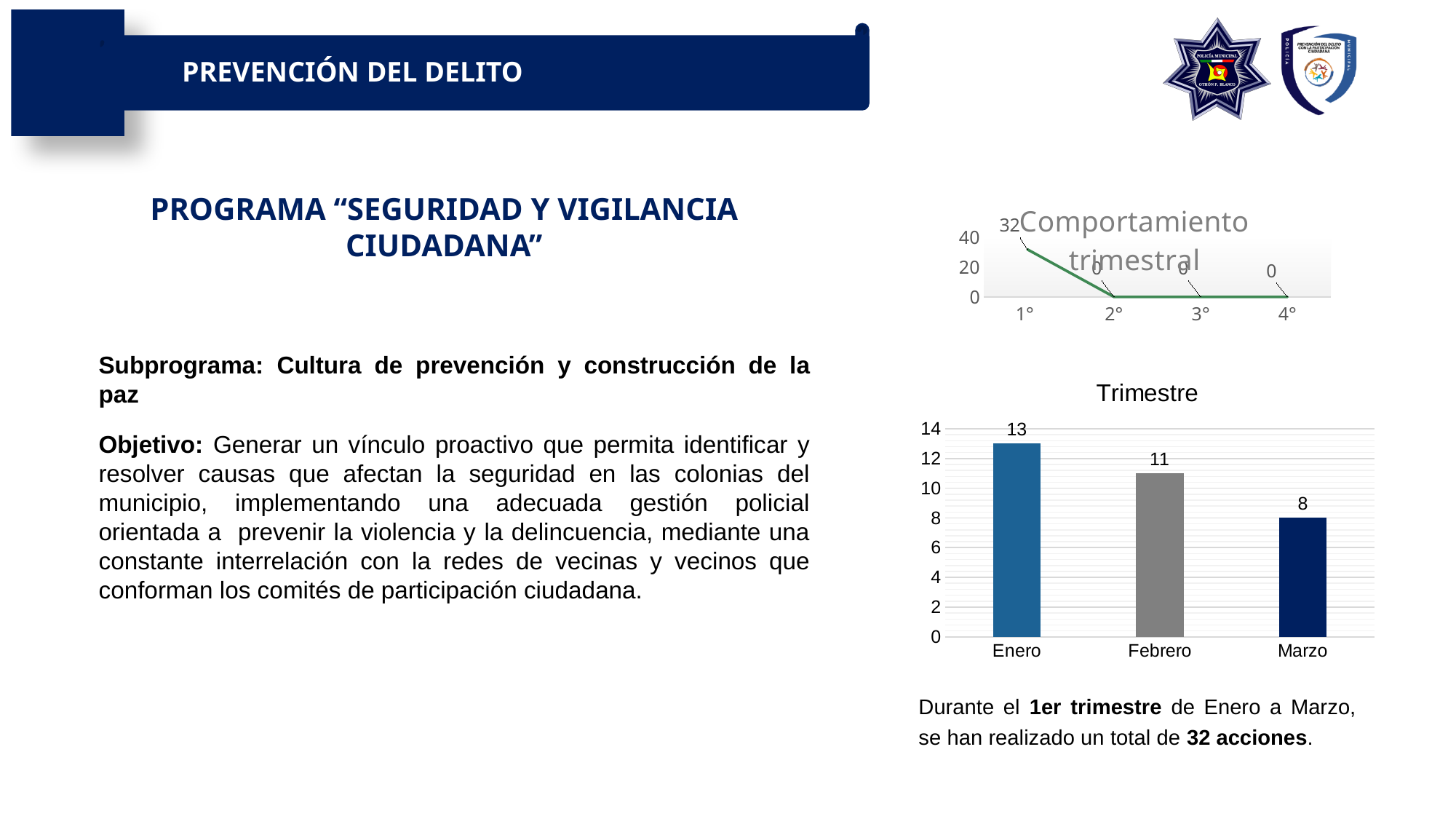
What kind of chart is the "Comportamiento trimestral" chart? Line chart In the "Trimestre" chart, what is the value for Enero? 13 In the "Trimestre" chart, what is the value for Marzo? 8 In the "Trimestre" chart, do the values rise or fall from Enero to Marzo? Fall In the "Trimestre" chart, what is the value for Febrero? 11 What kind of chart is the "Trimestre" chart? Bar chart In the "Trimestre" chart, what is the difference between the values for Enero and Marzo? 5 In the "Trimestre" chart, how many months are shown? 3 In the "Comportamiento trimestral" chart, what is the value for 1°? 32 In the "Trimestre" chart, which month has the lowest value? Marzo In the "Trimestre" chart, which is larger, the value for Febrero or the value for Marzo? Febrero In the "Trimestre" chart, which month has the highest value? Enero